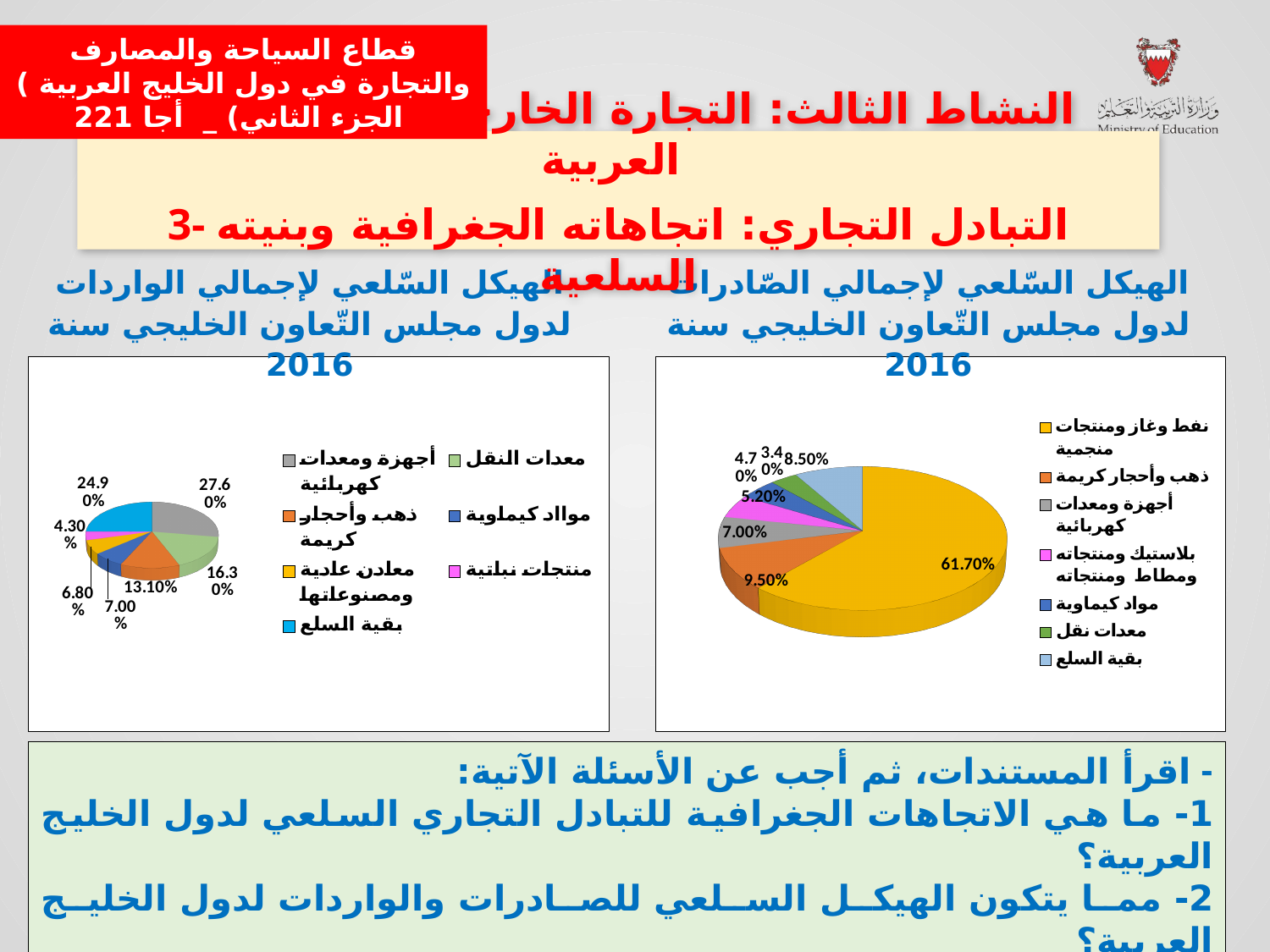
In the left chart (commodity structure of total imports, 2016), what share is shown for electrical equipment and devices (أجهزة ومعدات كهربائية)? 27.60% In the left chart (commodity structure of total imports, 2016), which category has the largest share? أجهزة ومعدات كهربائية (electrical equipment), 27.60% In the left chart (commodity structure of total imports, 2016), which is larger: the share of transport equipment (معدات النقل) or the share of gold and precious stones (ذهب وأحجار كريمة)? معدات النقل (transport equipment), 16.30% In the right chart (commodity structure of total exports, 2016), which category has the smallest share? معدات نقل (transport equipment), 3.40% In the right chart (commodity structure of total exports, 2016), how many categories does the legend list? 7 In the right chart (commodity structure of total exports, 2016), what is the difference between the share of oil, gas and mining products and the share of gold and precious stones? 52.20% In the left chart (commodity structure of total imports, 2016), what share is shown for the rest of goods (بقية السلع)? 24.90% In the right chart (commodity structure of total exports, 2016), what share is shown for gold and precious stones (ذهب وأحجار كريمة)? 9.50% In the right chart (commodity structure of total exports, 2016), what share is shown for oil, gas and mining products (نفط وغاز ومنتجات منجمية)? 61.70% How many pie charts are shown on the slide? 2 What type of chart is used on the right side of the slide for the commodity structure of total exports of GCC countries in 2016? Pie chart